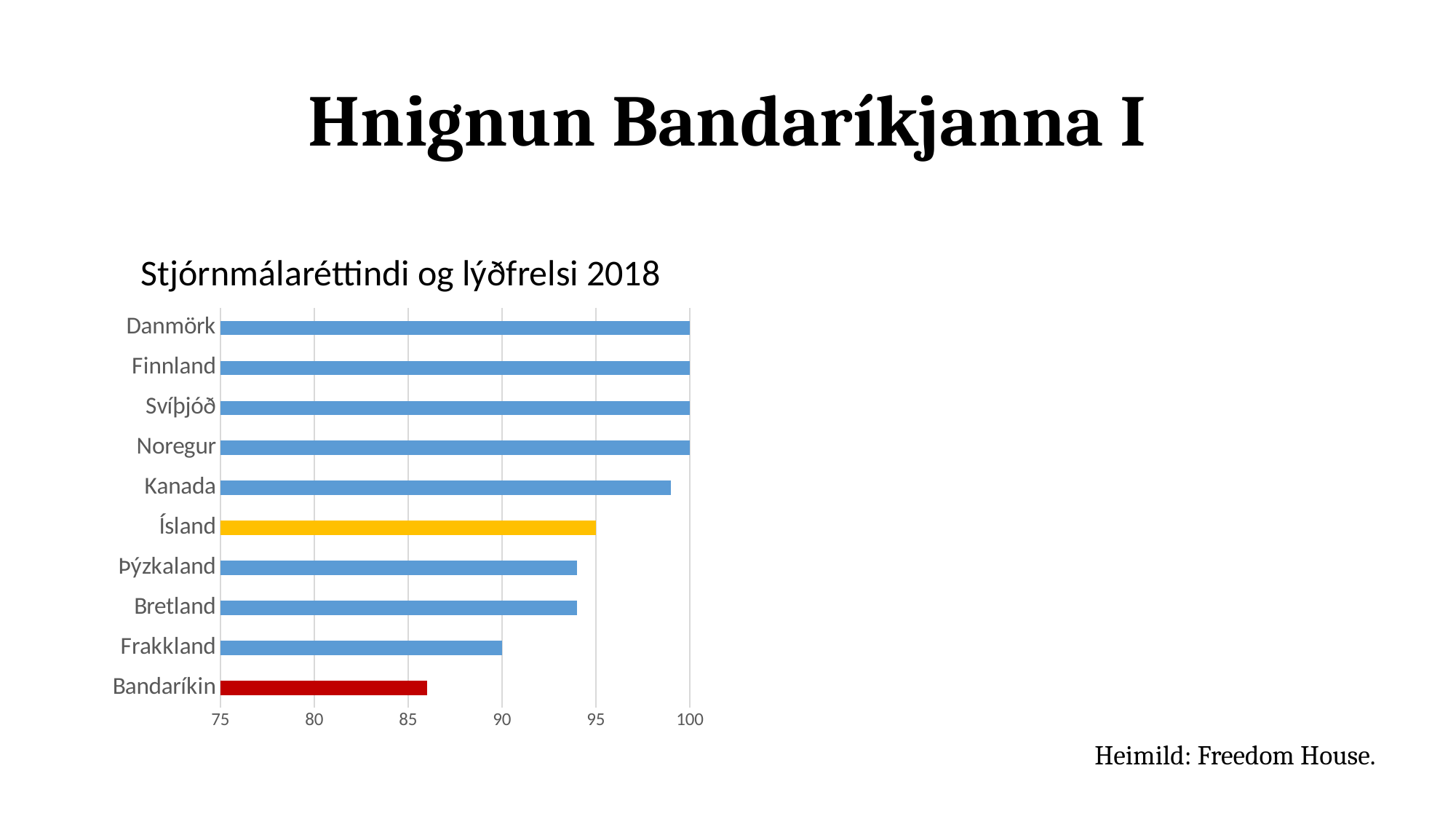
What colour is the bar for Bandaríkin? Red Is the value for Bandaríkin greater or less than 90? less What is the title of the chart? Stjórnmálaréttindi og lýðfrelsi 2018 Is the value for Kanada greater or less than 95? greater What is the value for Frakkland? 90 Which country has the lowest value? Bandaríkin Which has a larger value, Ísland or Frakkland? Ísland How many countries are shown in the chart? 10 What is the value for Danmörk? 100 What is the difference between the values for Ísland and Frakkland? 5 What type of chart is shown on the slide? Bar chart What is the value for Ísland? 95